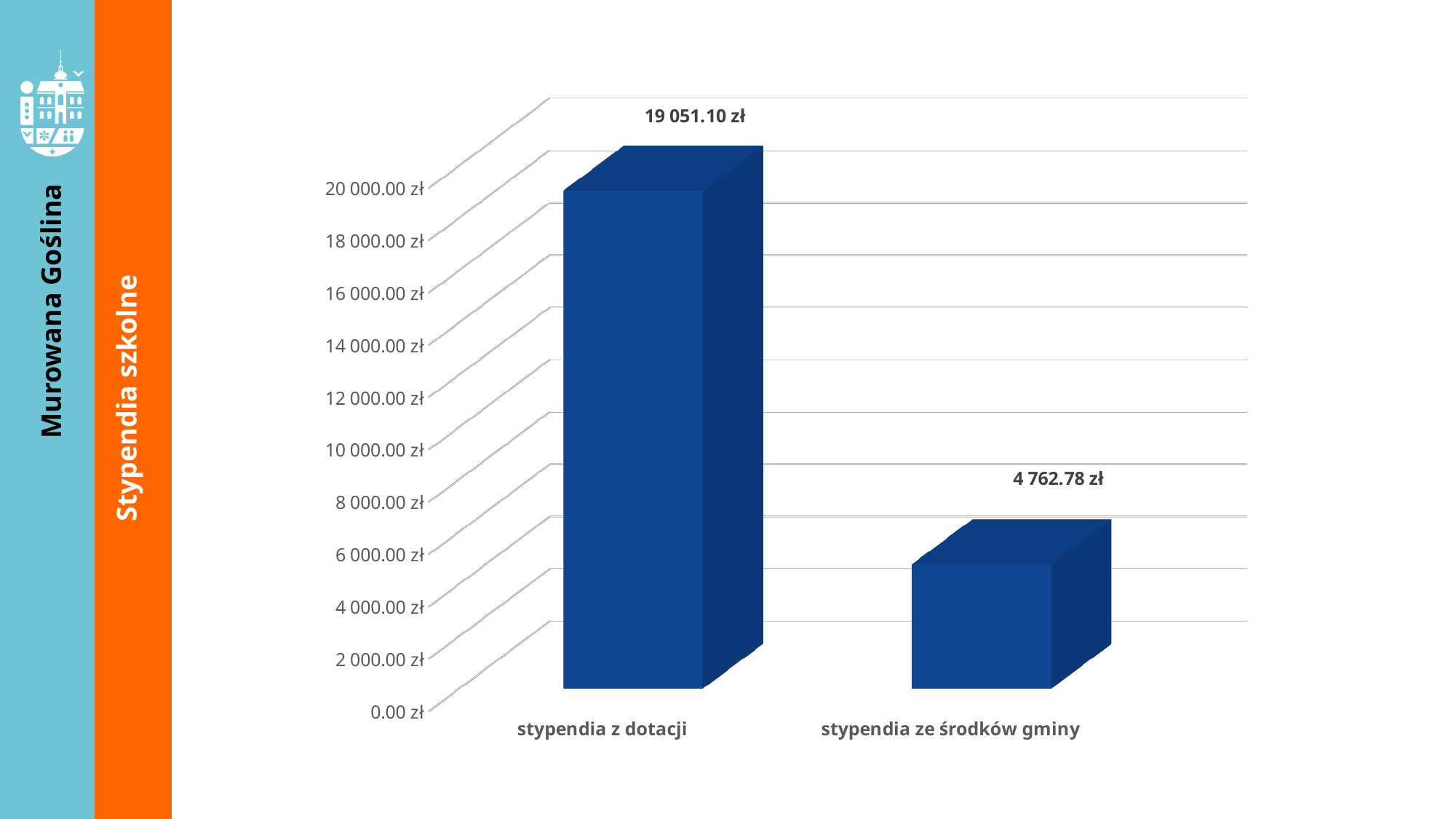
What kind of chart is shown on the slide? bar chart What is the value for "stypendia z dotacji"? 19 051.10 zł What is the title shown on the orange band of the slide? Stypendia szkolne Which category has the highest value? stypendia z dotacji Which is larger: the value for "stypendia z dotacji" or for "stypendia ze środków gminy"? stypendia z dotacji Which category has the lowest value? stypendia ze środków gminy What is the total of the two values shown on the chart? 23 813.88 zł What is the difference between the values for "stypendia z dotacji" and "stypendia ze środków gminy"? 14 288.32 zł Is the value for "stypendia ze środków gminy" greater or less than 6 000.00 zł? less What is the value for "stypendia ze środków gminy"? 4 762.78 zł Is the value for "stypendia z dotacji" greater or less than 18 000.00 zł? greater How many categories are shown on the chart? 2